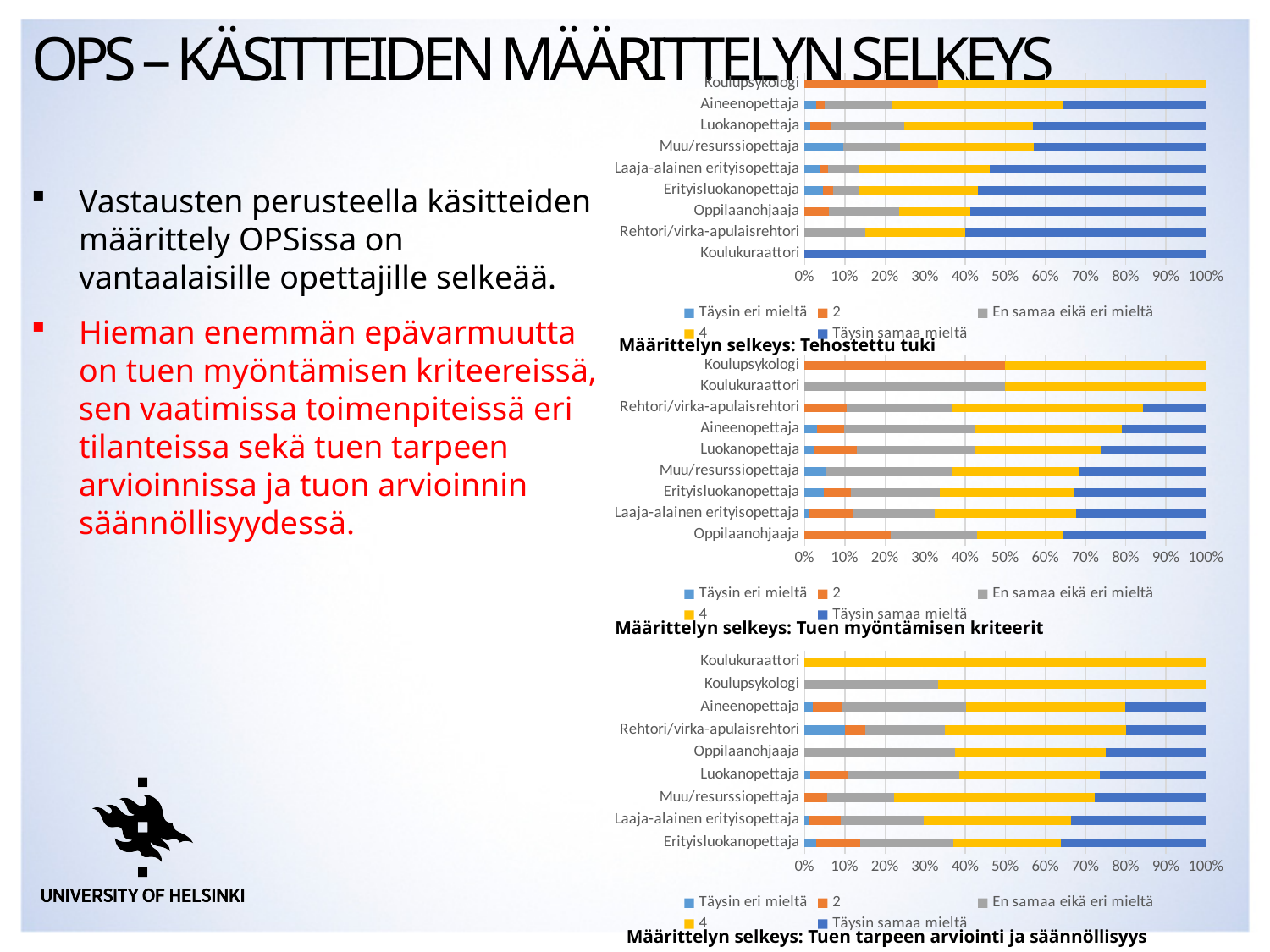
In the middle chart (Määrittelyn selkeys: Tuen myöntämisen kriteerit), is the 'En samaa eikä eri mieltä' share for Koulukuraattori greater or less than 90%? less In the bottom chart (Määrittelyn selkeys: Tuen tarpeen arviointi ja säännöllisyys), is the '4' share for Koulukuraattori greater or less than 90%? greater In the top chart (Määrittelyn selkeys: Tehostettu tuki), is the '2' share for Koulupsykologi greater or less than 20%? greater What is the title of the bottom chart on the slide? Määrittelyn selkeys: Tuen tarpeen arviointi ja säännöllisyys In the top chart (Määrittelyn selkeys: Tehostettu tuki), which category has the smallest 'Täysin samaa mieltä' share? Koulupsykologi How many series does the legend of the middle chart (Määrittelyn selkeys: Tuen myöntämisen kriteerit) list? 5 What kind of chart is the top chart (Määrittelyn selkeys: Tehostettu tuki)? Stacked bar chart In the top chart (Määrittelyn selkeys: Tehostettu tuki), which has the larger 'Täysin samaa mieltä' share: Aineenopettaja or Oppilaanohjaaja? Oppilaanohjaaja How many categories are shown on the y axis of the top chart (Määrittelyn selkeys: Tehostettu tuki)? 9 In the top chart (Määrittelyn selkeys: Tehostettu tuki), which category has the largest 'Täysin samaa mieltä' share? Koulukuraattori